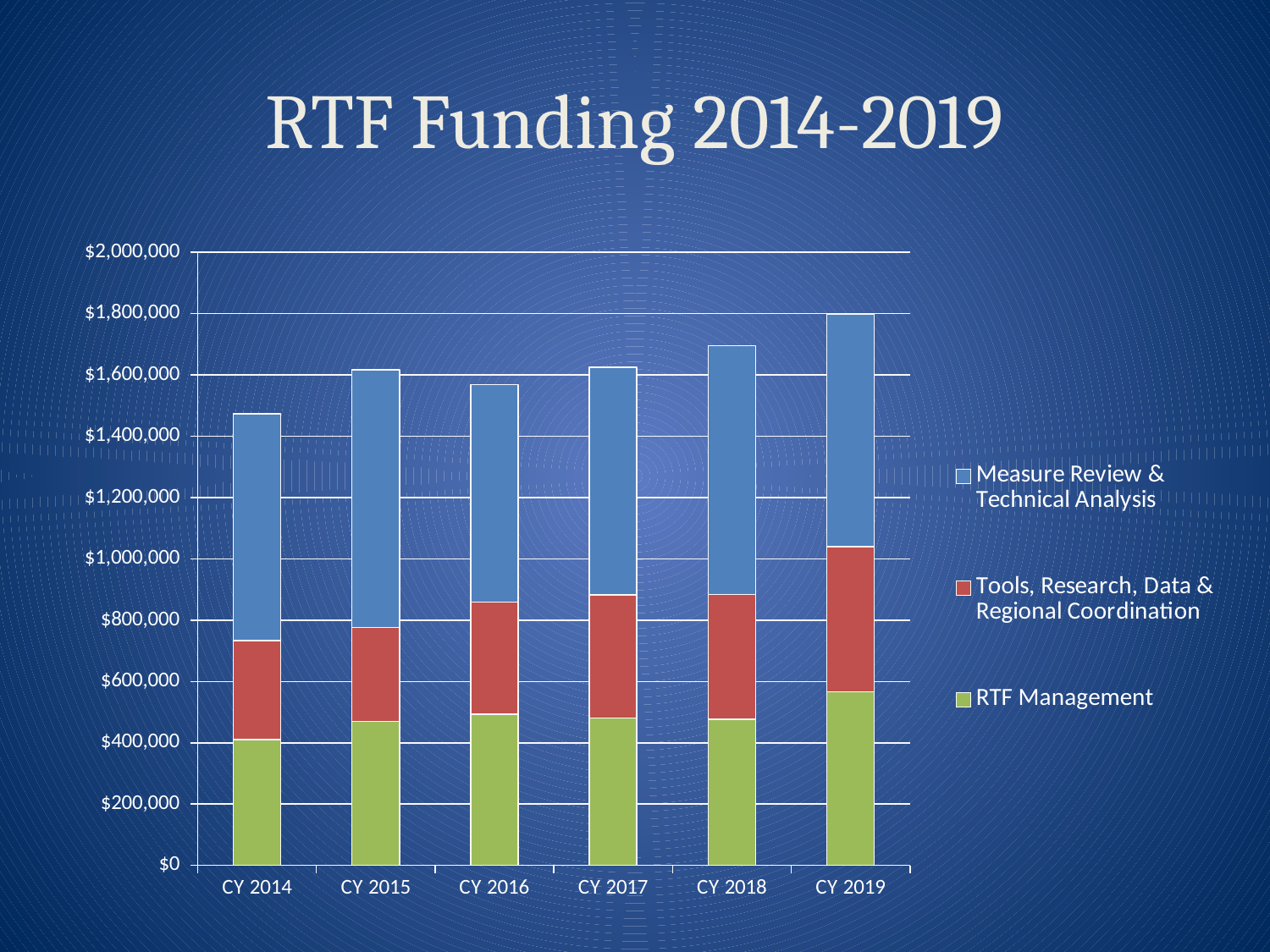
How many years (categories) are shown on the x axis? 6 How many series does the legend list? 3 What kind of chart is shown on the slide? Stacked bar chart Is the total funding for CY 2019 greater or less than $1,600,000? greater Overall, do the total funding bars rise or fall from CY 2014 to CY 2019? rise Which year has the larger total funding bar, CY 2018 or CY 2016? CY 2018 Is the RTF Management value for CY 2019 greater or less than $400,000? greater Which series is shown in green? RTF Management Is the total funding for CY 2014 greater or less than $1,600,000? less What is the title of the chart? RTF Funding 2014-2019 Which year has the highest total funding bar? CY 2019 Which year has the lowest total funding bar? CY 2014